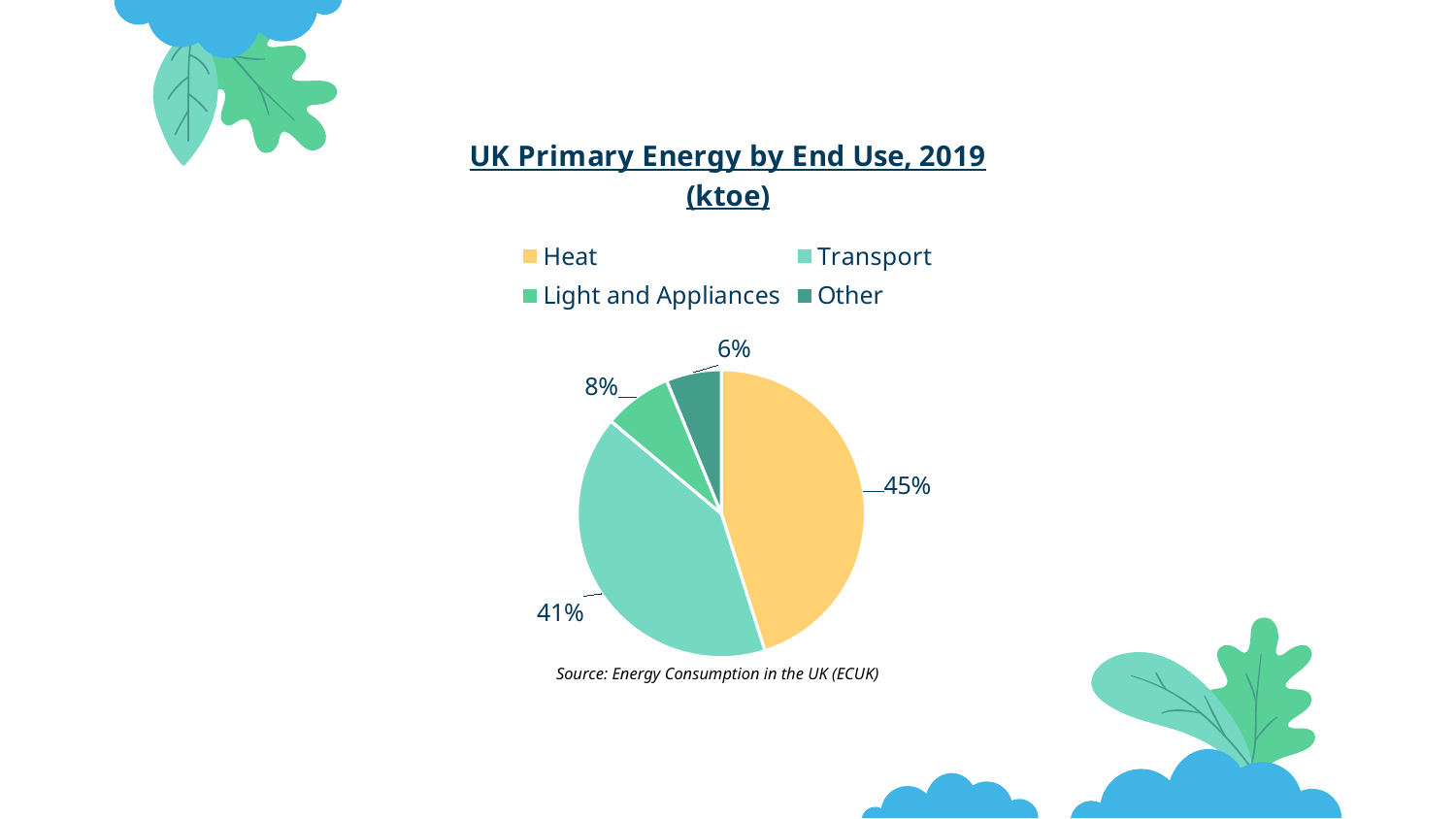
What kind of chart is shown on the slide? Pie chart Which end use has the smallest share of the pie? Other What is the title of the chart? UK Primary Energy by End Use, 2019 (ktoe) What is the difference in percentage points between Heat and Transport? 4 What percentage is shown for Other? 6% Which is larger, the share for Light and Appliances or the share for Other? Light and Appliances What share of UK primary energy by end use in 2019 is Heat? 45% What share of the pie does Transport account for? 41% Which end use has the largest share of the pie? Heat What source is cited below the chart? Energy Consumption in the UK (ECUK) What percentage is shown for Light and Appliances? 8% How many categories does the pie chart show? 4